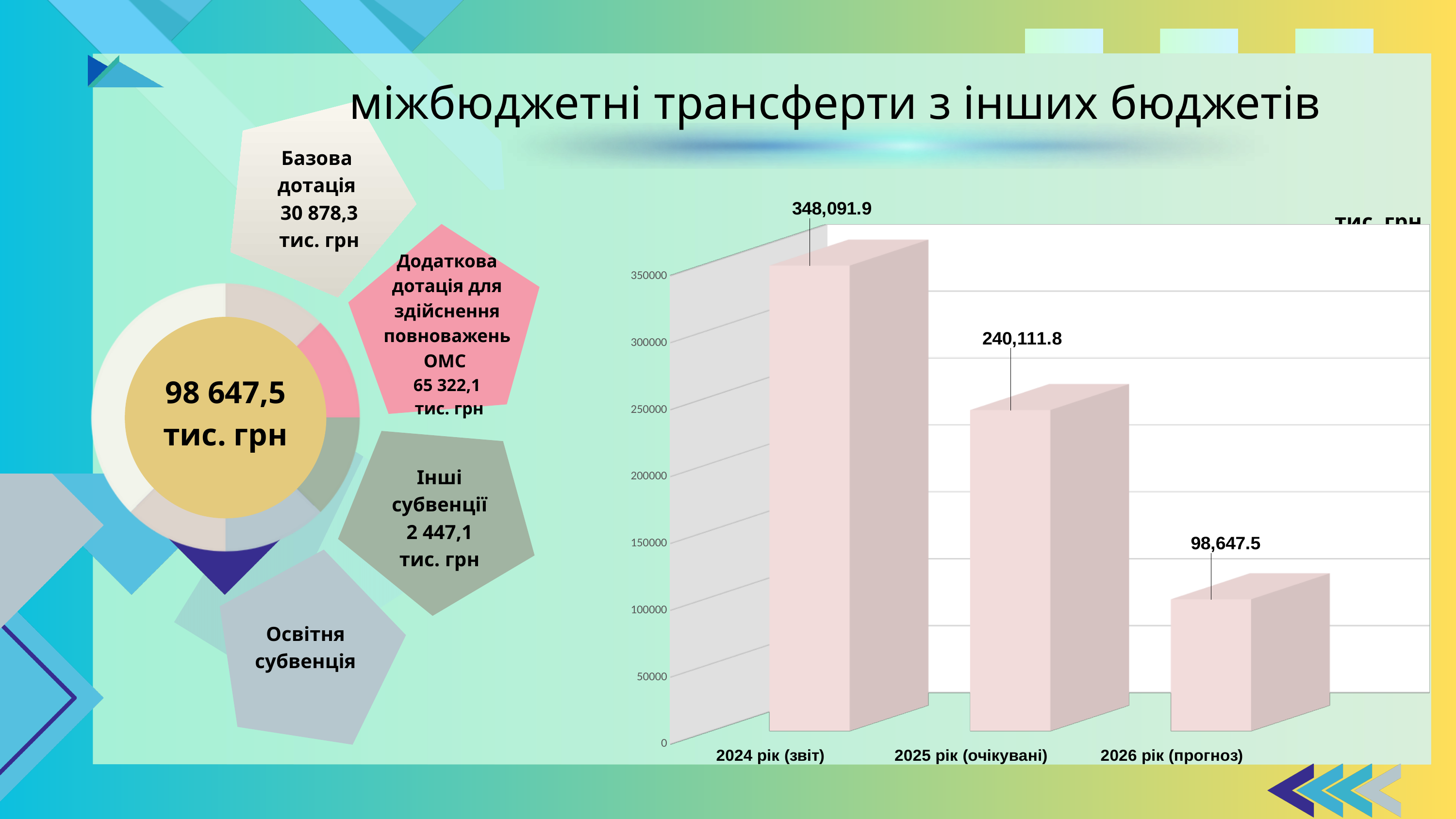
On the bar chart on the right, which year has the lowest value? 2026 рік (прогноз) On the bar chart on the right, do the values rise or fall from 2024 to 2026? fall On the bar chart on the right, what is the value for 2025 рік (очікувані)? 240,111.8 On the bar chart on the right, what is the difference between the values for 2024 рік (звіт) and 2025 рік (очікувані)? 107,980.1 On the bar chart on the right, what is the difference between the values for 2025 рік (очікувані) and 2026 рік (прогноз)? 141,464.3 On the bar chart on the right, what is the value for 2026 рік (прогноз)? 98,647.5 What kind of chart is shown on the right side of the slide? bar chart On the donut chart on the left, what total value is shown in the centre? 98 647,5 тис. грн On the bar chart on the right, what is the value for 2024 рік (звіт)? 348,091.9 On the bar chart on the right, how many bars are plotted? 3 On the bar chart on the right, which is larger: the value for 2025 рік (очікувані) or 2026 рік (прогноз)? 2025 рік (очікувані) On the bar chart on the right, which year has the highest value? 2024 рік (звіт)